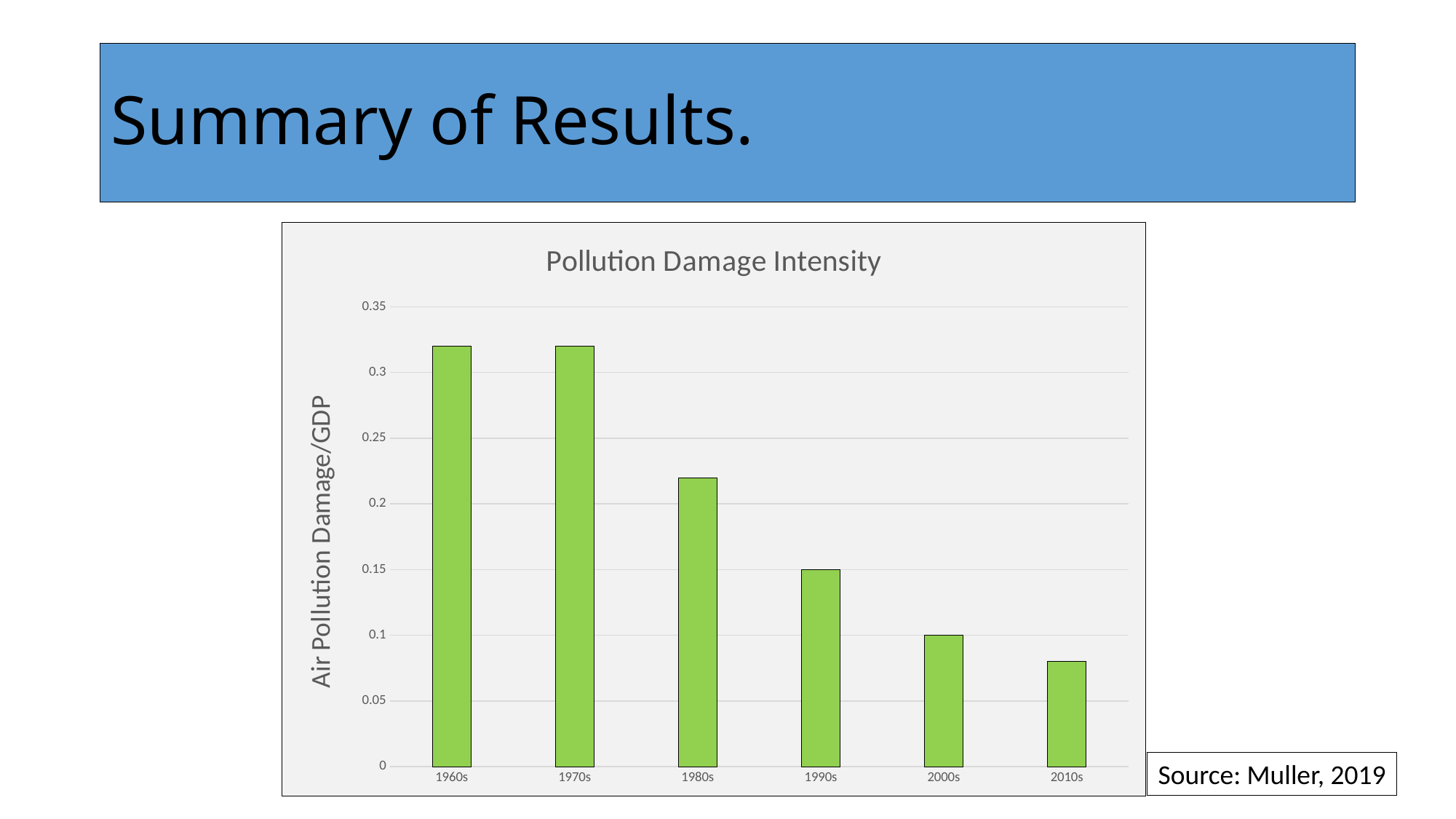
What is the title of the chart? Pollution Damage Intensity Which has a higher Air Pollution Damage/GDP, the 1980s or the 1990s? 1980s What is the Air Pollution Damage/GDP value for the 1990s? 0.15 What is the label on the vertical axis of the chart? Air Pollution Damage/GDP Is the value for the 1980s greater or less than 0.2? greater How many decades are shown on the x axis of the chart? 6 Is the value for the 1960s greater or less than 0.3? greater Do the values rise or fall from the 1960s to the 2010s? fall Is the value for the 2010s greater or less than 0.1? less What kind of chart is shown on the slide? bar chart Which decade has the lowest Air Pollution Damage/GDP? 2010s What is the Air Pollution Damage/GDP value for the 2000s? 0.1